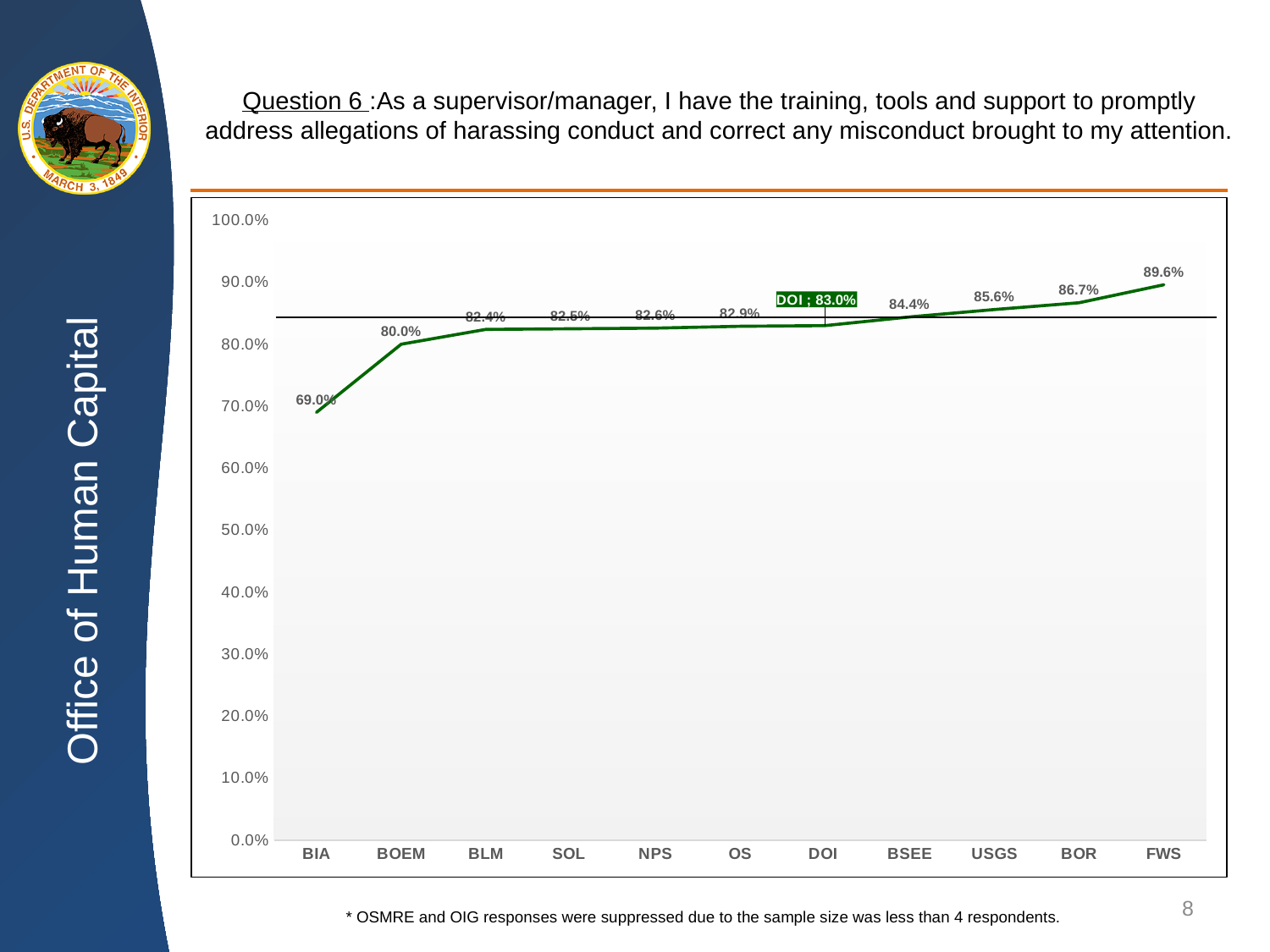
What is the value for FWS? 89.6% Which is larger, the value for BOR or the value for BSEE? BOR What is the value for BIA? 69.0% How many categories are shown on the x axis? 11 What is the value for DOI? 83.0% What is the difference between the values for FWS and BIA? 20.6% What is the value for BOEM? 80.0% Is the value for BIA greater or less than 70.0%? less Which category has the lowest value? BIA Which category has the highest value? FWS What kind of chart is shown on the slide? line chart What is the value for USGS? 85.6%